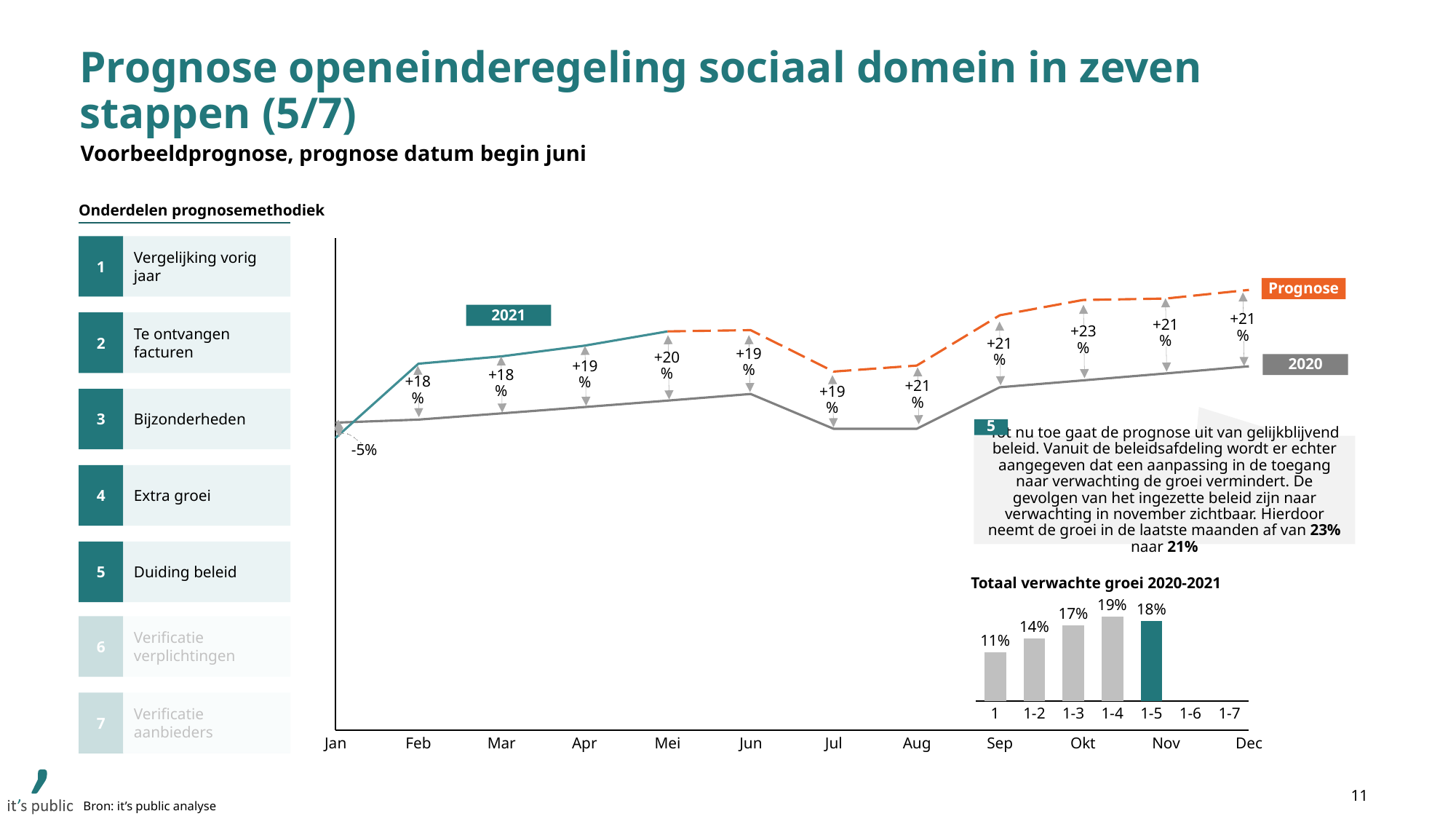
In the large line chart, which month has the highest labelled growth percentage? Okt In the large line chart, which month has the larger labelled growth percentage, Apr or Mei? Mei In the bar chart 'Totaal verwachte groei 2020-2021', what is the difference between the values for 1-4 and 1-5? 1% In the large line chart, how many months are shown on the x axis? 12 What kind of chart is 'Totaal verwachte groei 2020-2021'? Bar chart In the bar chart 'Totaal verwachte groei 2020-2021', what is the value for category 1-3? 17% In the large line chart, what growth percentage is labelled for Okt? +23% In the large line chart, what growth percentage is labelled for Jan? -5% In the bar chart 'Totaal verwachte groei 2020-2021', which category is shown in teal instead of grey? 1-5 In the bar chart 'Totaal verwachte groei 2020-2021', which category has the lowest plotted value? 1 In the bar chart 'Totaal verwachte groei 2020-2021', which category has the highest value? 1-4 In the bar chart 'Totaal verwachte groei 2020-2021', how many bars have a plotted value? 5